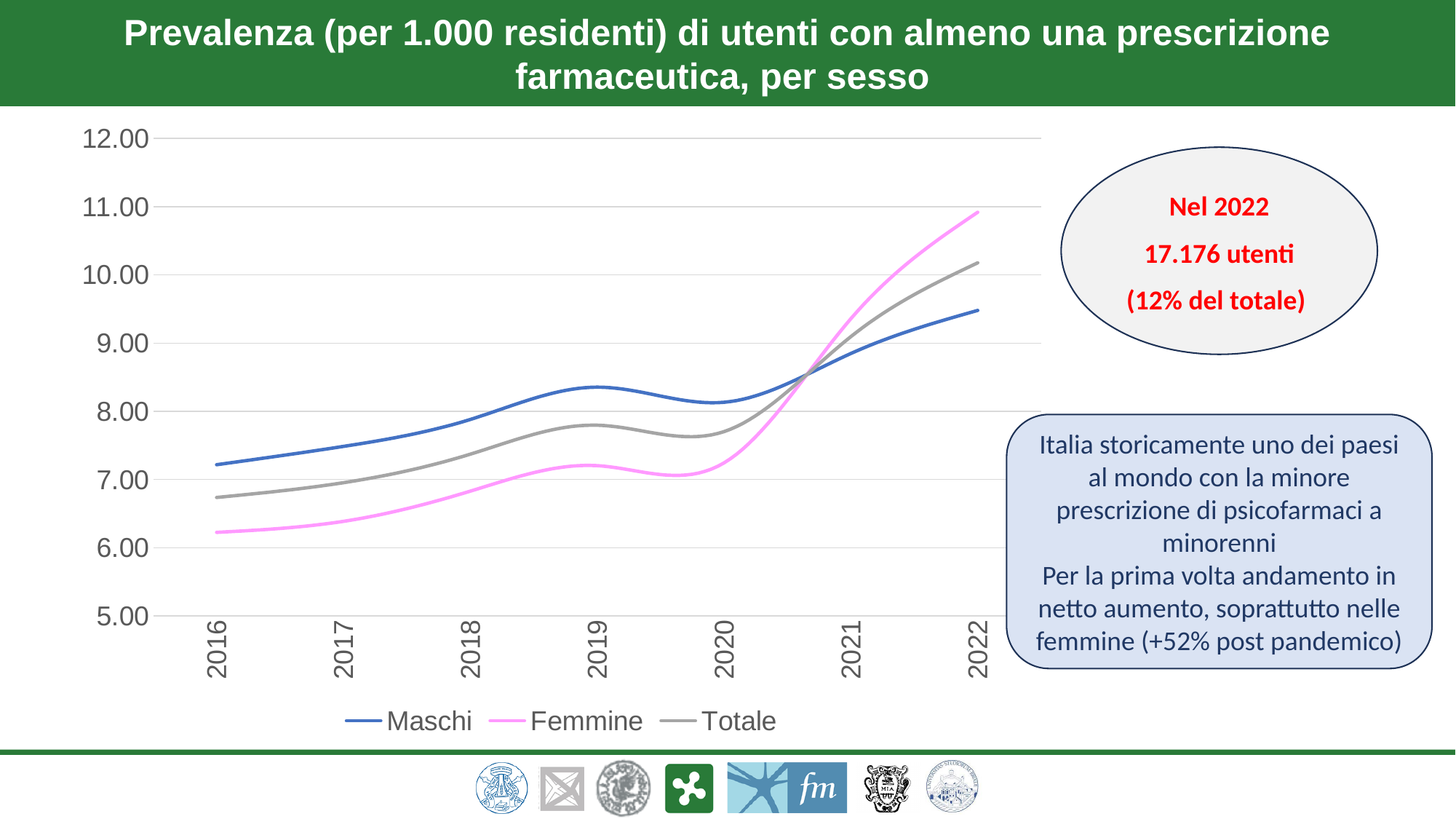
What kind of chart is shown on the slide? line chart What is the title of the chart? Prevalenza (per 1.000 residenti) di utenti con almeno una prescrizione farmaceutica, per sesso Is the value for Maschi in 2022 greater or less than 9.00? greater In 2022, which is larger: the value for Femmine or the value for Maschi? Femmine How many series does the legend list? 3 Is the value for Femmine in 2016 greater or less than 7.00? less Does the Femmine line rise or fall between 2020 and 2022? rises In 2016, which is larger: the value for Maschi or the value for Femmine? Maschi Which series has the highest value in 2022? Femmine How many years are shown on the x axis? 7 Which series has the lowest value in 2016? Femmine Is the value for Femmine in 2022 greater or less than 10.00? greater